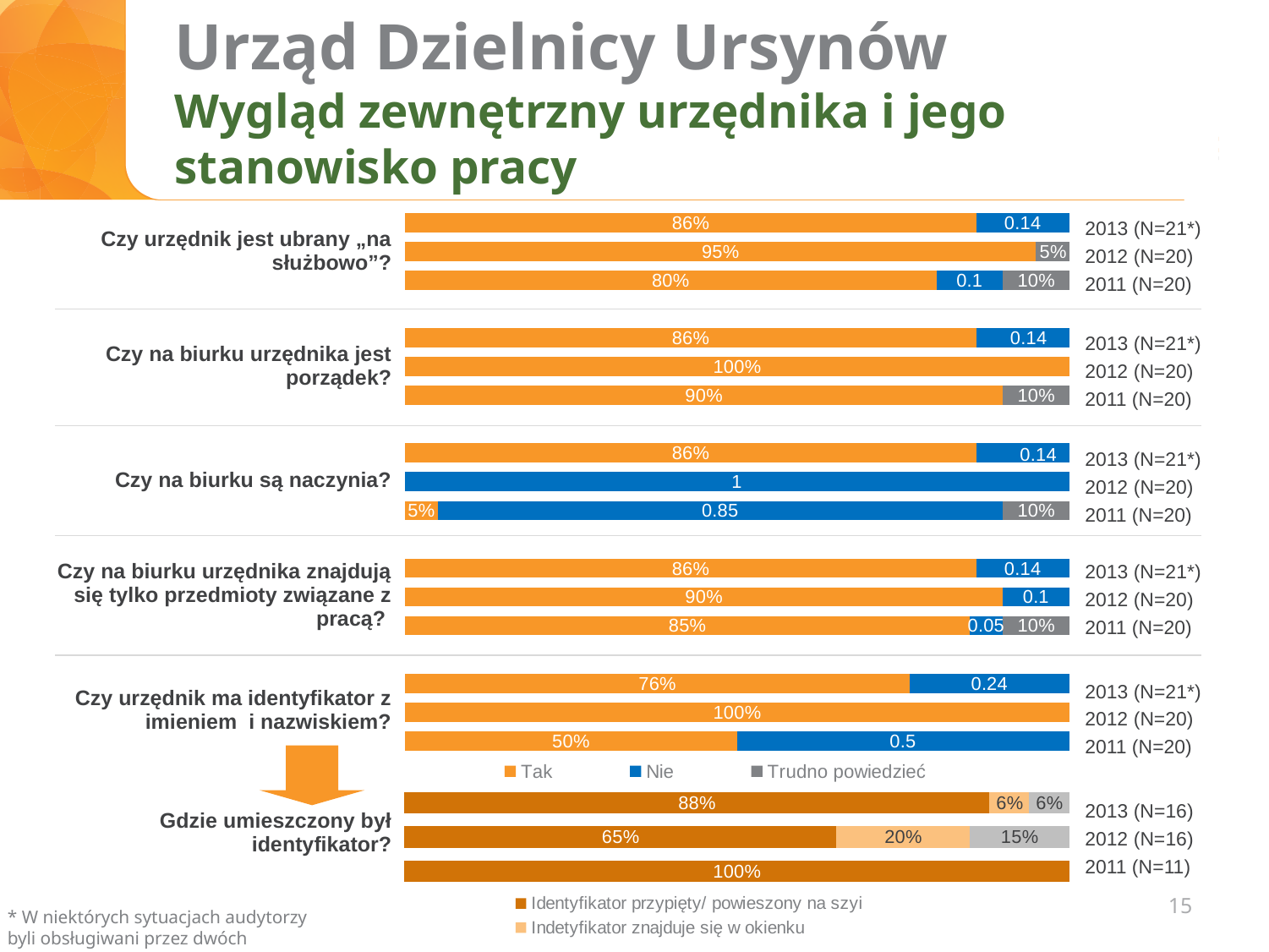
In the chart "Czy urzędnik ma identyfikator z imieniem i nazwiskiem?", which year has the lowest "Tak" value? 2011 (N=20) In the chart "Gdzie umieszczony był identyfikator?", what is the "Identyfikator przypięty/ powieszony na szyi" value for 2012 (N=16)? 65% In the chart "Czy na biurku urzędnika znajdują się tylko przedmioty związane z pracą?", what is the "Tak" value for 2011 (N=20)? 85% What kind of chart is used for "Czy urzędnik jest ubrany „na służbowo”?"? Stacked bar chart In the chart "Czy urzędnik jest ubrany „na służbowo”?", what is the "Trudno powiedzieć" value for 2011 (N=20)? 10% In the chart "Czy urzędnik ma identyfikator z imieniem i nazwiskiem?", what is the "Nie" value for 2013 (N=21*)? 0.24 In the chart "Czy na biurku urzędnika jest porządek?", which year has the highest "Tak" value? 2012 (N=20) In the chart "Gdzie umieszczony był identyfikator?", what is the difference between the "Identyfikator przypięty/ powieszony na szyi" values for 2013 (N=16) and 2012 (N=16)? 23% In the chart "Gdzie umieszczony był identyfikator?", how many years are shown? 3 In the chart "Czy na biurku są naczynia?", what is the "Tak" value for 2011 (N=20)? 5% In the chart "Czy na biurku są naczynia?", what is the "Nie" value for 2013 (N=21*)? 0.14 In the chart "Czy urzędnik jest ubrany „na służbowo”?", what is the "Tak" value for 2012 (N=20)? 95%